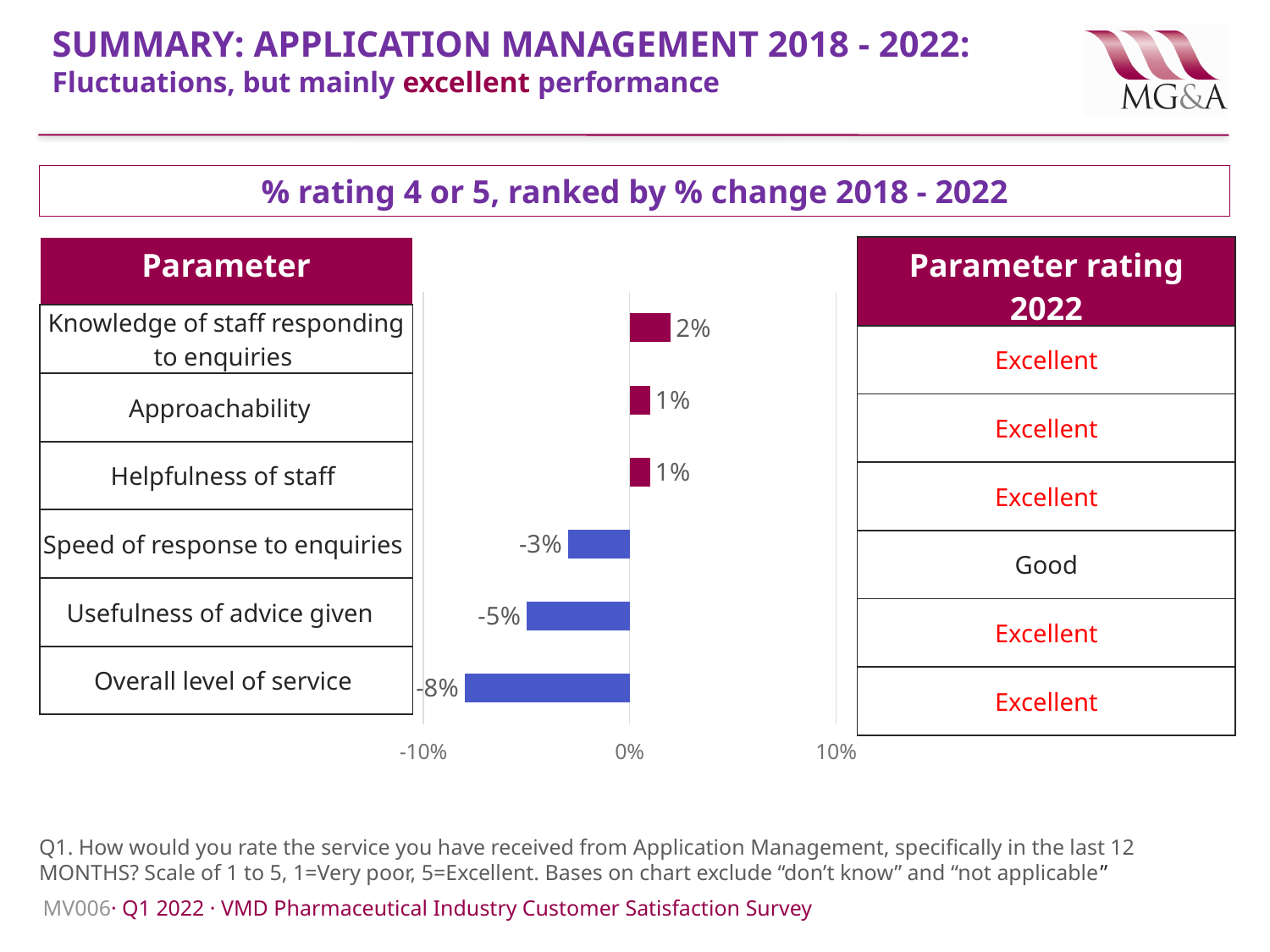
What is the % change 2018 - 2022 for Overall level of service? -8% What is the % change 2018 - 2022 for Knowledge of staff responding to enquiries? 2% What kind of chart is shown on the slide? Bar chart Which parameter has the lowest % change 2018 - 2022? Overall level of service What is the % change 2018 - 2022 for Speed of response to enquiries? -3% What is the % change 2018 - 2022 for Usefulness of advice given? -5% How many parameters are shown in the chart? 6 Which parameter has the highest % change 2018 - 2022? Knowledge of staff responding to enquiries What is the difference between the % change for Knowledge of staff responding to enquiries and Overall level of service? 10 percentage points What is the title of the chart? % rating 4 or 5, ranked by % change 2018 - 2022 Which parameter has a 2022 rating of Good? Speed of response to enquiries Which has a larger % change 2018 - 2022: Speed of response to enquiries or Usefulness of advice given? Speed of response to enquiries